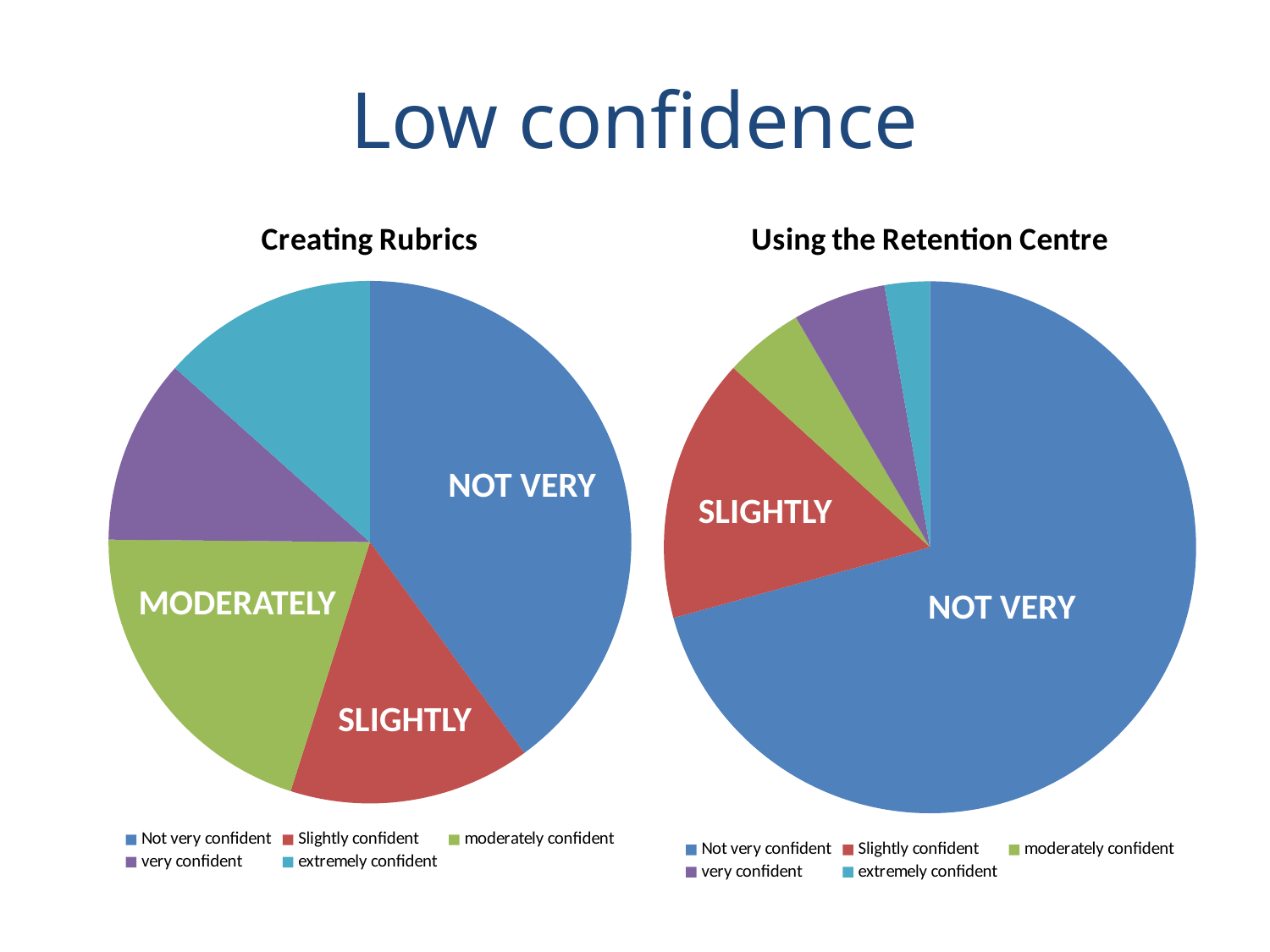
In the Creating Rubrics chart, which slice is larger: moderately confident or Slightly confident? moderately confident In the Creating Rubrics chart, which category has the largest slice? Not very confident What is the title of the slide? Low confidence What colour is the Slightly confident slice in the Using the Retention Centre chart? red In the Using the Retention Centre chart, which category has the smallest slice? extremely confident In the Using the Retention Centre chart, which category has the largest slice? Not very confident What kind of chart is the Using the Retention Centre chart? pie chart How many slices does the Using the Retention Centre pie chart have? 5 What kind of chart is the Creating Rubrics chart? pie chart In the Using the Retention Centre chart, which slice is larger: Slightly confident or moderately confident? Slightly confident How many series does the legend of the Creating Rubrics chart list? 5 In the Creating Rubrics chart, which slice is larger: Not very confident or Slightly confident? Not very confident